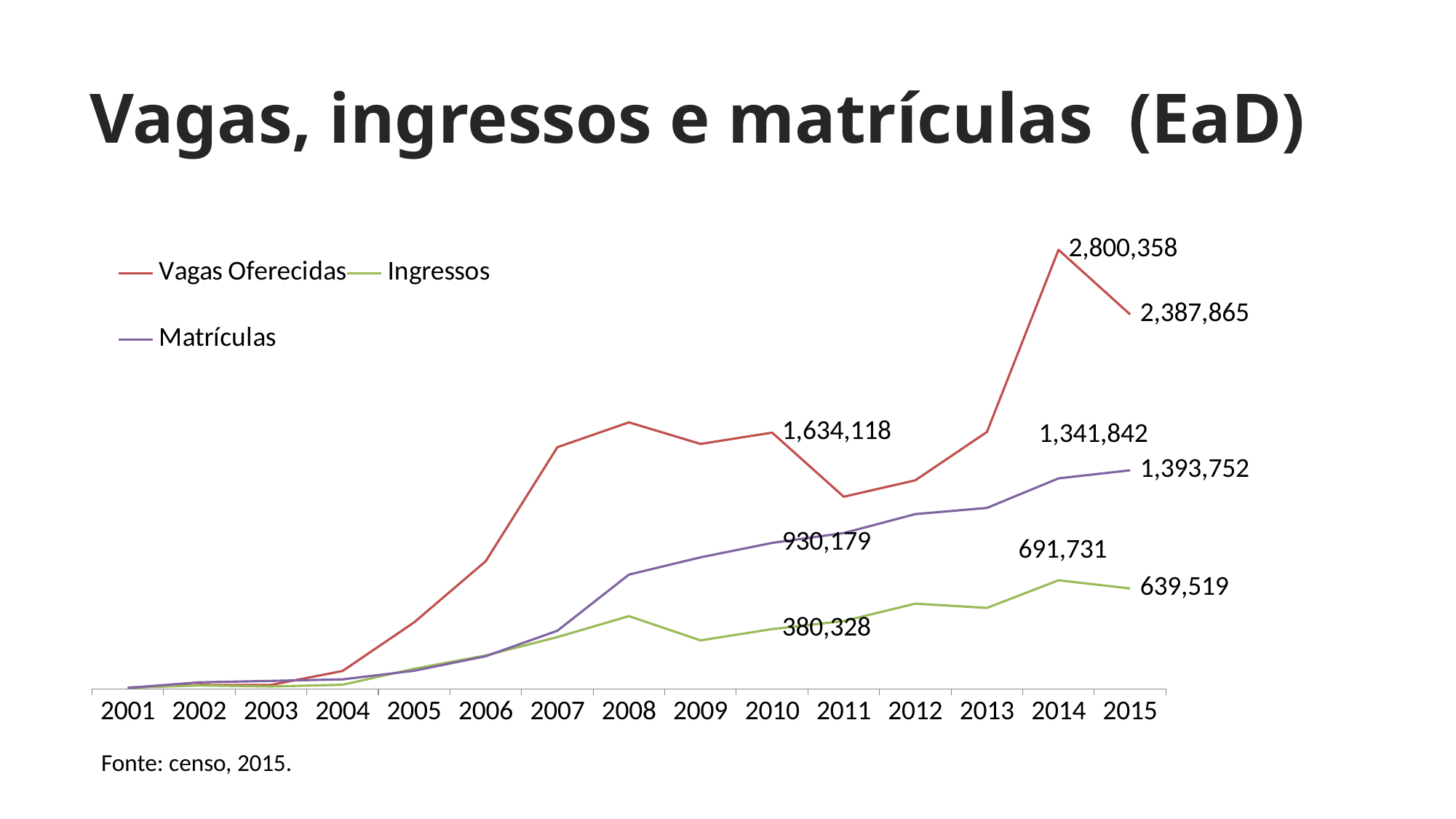
By how much did Vagas Oferecidas fall from 2014 to 2015? 412,493 What is the value of Ingressos in 2010? 380,328 Does the Matrículas line generally rise or fall from 2001 to 2015? rise What is the value of Matrículas in 2015? 1,393,752 How many years are shown on the x axis? 15 What is the value of Vagas Oferecidas in 2014? 2,800,358 What type of chart is shown on the slide? line chart What is the difference between Vagas Oferecidas and Matrículas in 2015? 994,113 How many series does the legend list? 3 In which year does Vagas Oferecidas reach its highest value? 2014 What is the value of Matrículas in 2010? 930,179 Which is larger in 2015, Matrículas or Ingressos? Matrículas